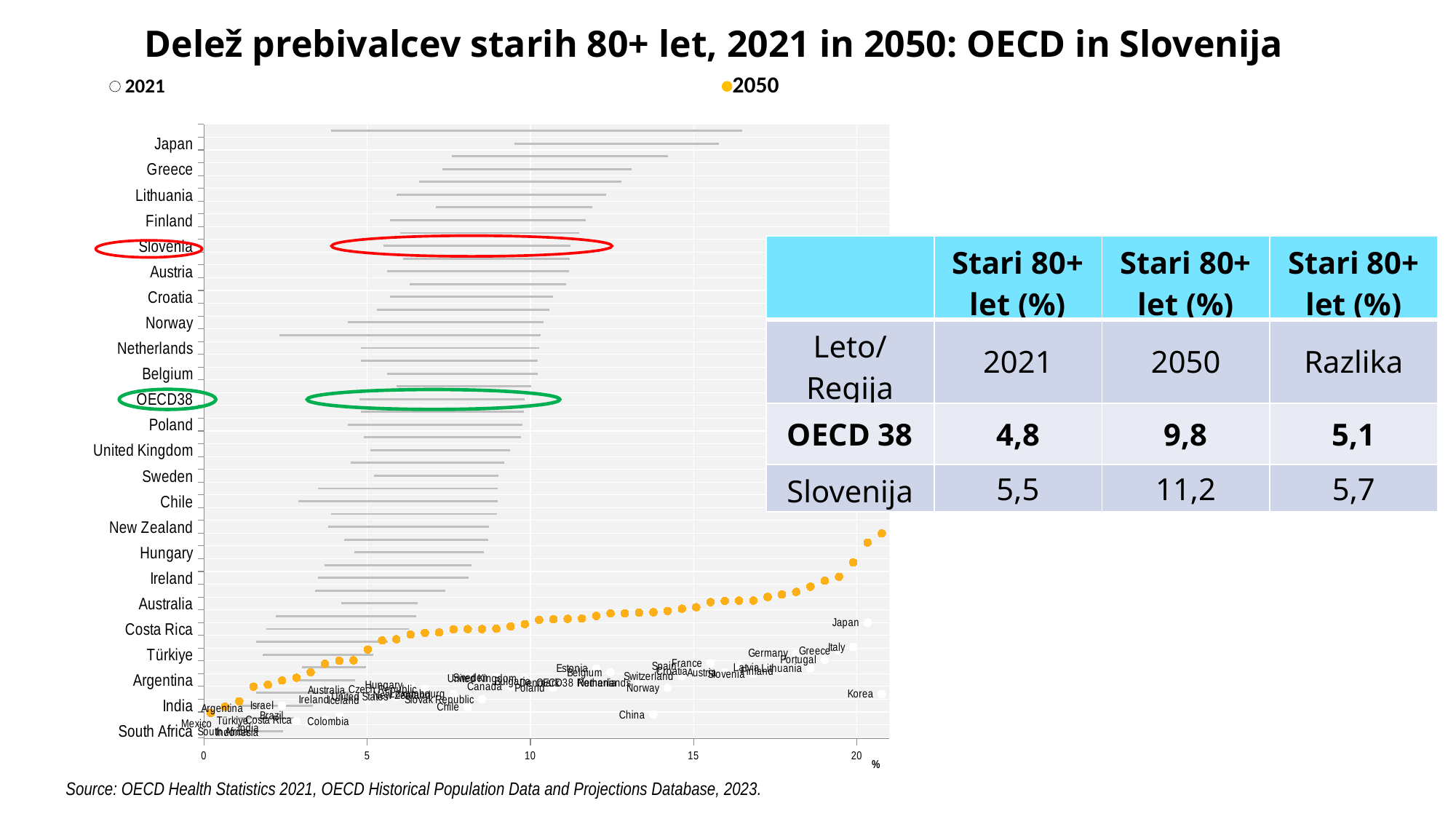
Which country has the highest projected share of people aged 80+ in 2050 in the chart? Korea Which series is shown with orange/yellow filled dots in the chart? 2050 According to the table, what is the share of people aged 80+ in Slovenia in 2021? 5,5 By how much does Slovenia's 2050 share exceed the OECD 38 share in 2050? 1,4 How many series does the chart legend list? 2 Which has the larger share of people aged 80+ in 2050, Slovenia or OECD 38? Slovenia According to the table, what is the share of people aged 80+ for OECD 38 in 2021? 4,8 According to the table, what is the share of people aged 80+ in Slovenia in 2050? 11,2 According to the table, what is the share of people aged 80+ for OECD 38 in 2050? 9,8 What is the difference (Razlika) between 2050 and 2021 for Slovenia shown in the table? 5,7 Is the highest 2050 value in the chart greater or less than 15? greater What is the title of the chart on the slide? Delež prebivalcev starih 80+ let, 2021 in 2050: OECD in Slovenija